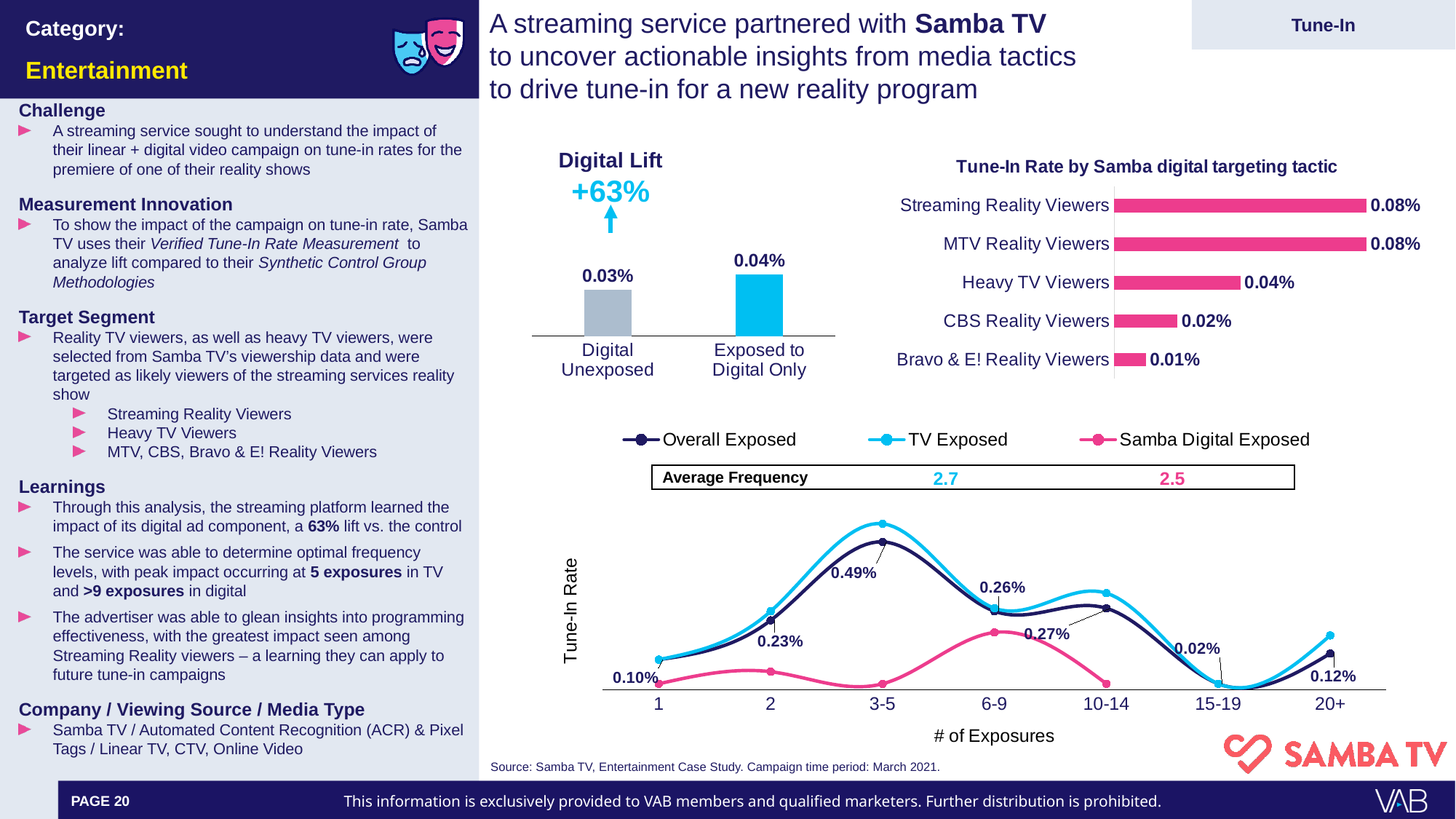
In the Digital Lift chart, what is the digital lift percentage shown above the bars? +63% In the line chart of tune-in rate by # of exposures, what is the average frequency shown for TV Exposed? 2.7 In the line chart of tune-in rate by # of exposures, how many exposure categories are on the x axis? 7 In the Tune-In Rate by Samba digital targeting tactic chart, how many targeting tactics are shown? 5 In the Tune-In Rate by Samba digital targeting tactic chart, which tactic has the lowest tune-in rate? Bravo & E! Reality Viewers In the Tune-In Rate by Samba digital targeting tactic chart, what is the tune-in rate for Heavy TV Viewers? 0.04% In the Tune-In Rate by Samba digital targeting tactic chart, which is larger: the tune-in rate for MTV Reality Viewers or for Heavy TV Viewers? MTV Reality Viewers In the Digital Lift chart, what is the tune-in rate for Digital Unexposed? 0.03% In the Digital Lift chart, what is the tune-in rate for Exposed to Digital Only? 0.04% In the line chart of tune-in rate by # of exposures, how many series does the legend list? 3 In the Tune-In Rate by Samba digital targeting tactic chart, what is the difference between the tune-in rates for Streaming Reality Viewers and CBS Reality Viewers? 0.06% What kind of chart is the Digital Lift chart? Bar chart